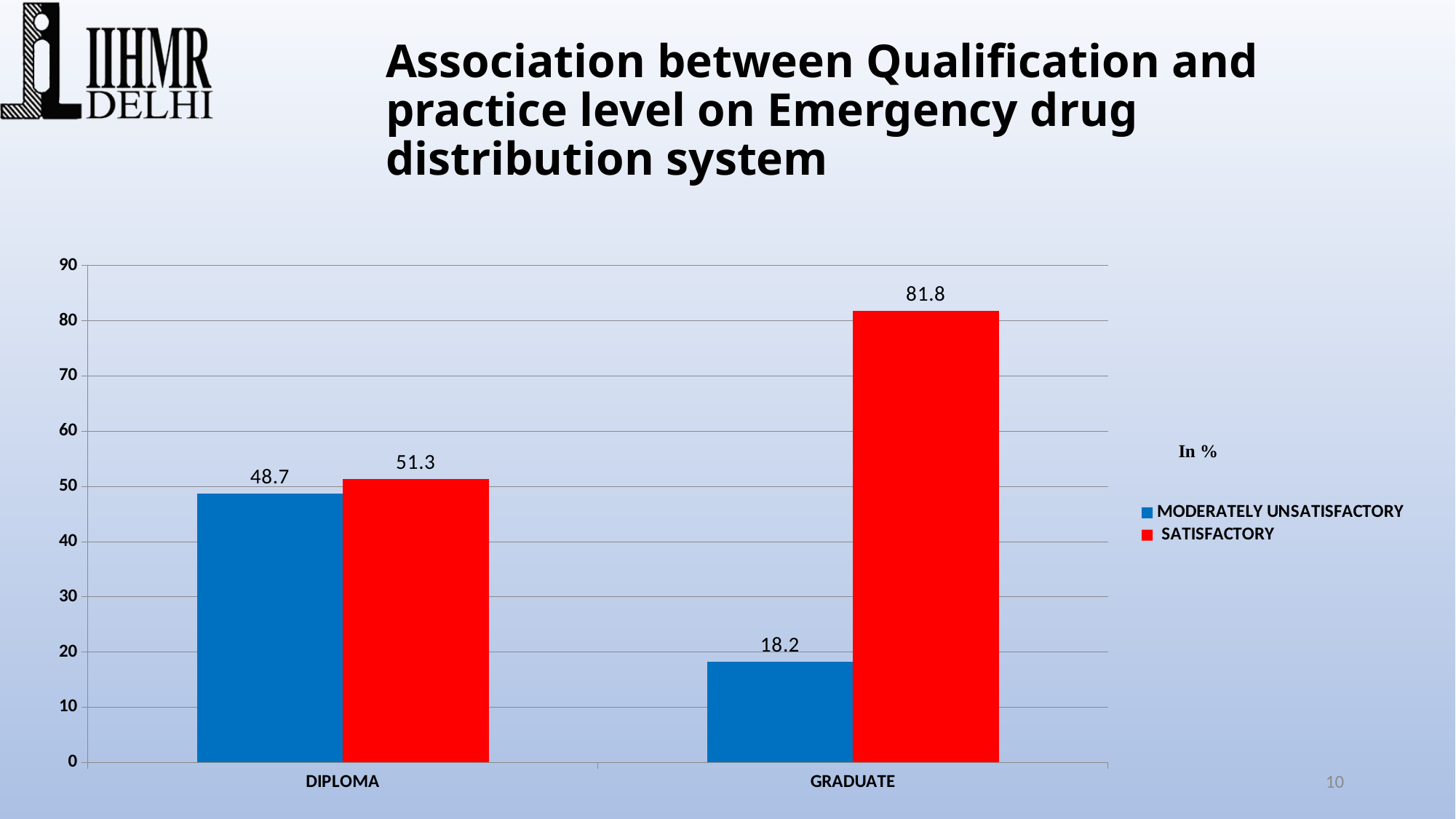
What is the value for SATISFACTORY in the GRADUATE category? 81.8 What colour represents the SATISFACTORY series? Red Which is larger for DIPLOMA: SATISFACTORY or MODERATELY UNSATISFACTORY? SATISFACTORY How many categories are shown on the x axis? 2 What is the value for SATISFACTORY in the DIPLOMA category? 51.3 How many series does the legend list? 2 What is the value for MODERATELY UNSATISFACTORY in the DIPLOMA category? 48.7 What is the value for MODERATELY UNSATISFACTORY in the GRADUATE category? 18.2 Which category has the lowest MODERATELY UNSATISFACTORY value? GRADUATE What is the difference between the SATISFACTORY and MODERATELY UNSATISFACTORY values for GRADUATE? 63.6 Which category has the highest SATISFACTORY value? GRADUATE What kind of chart is shown on the slide? Bar chart